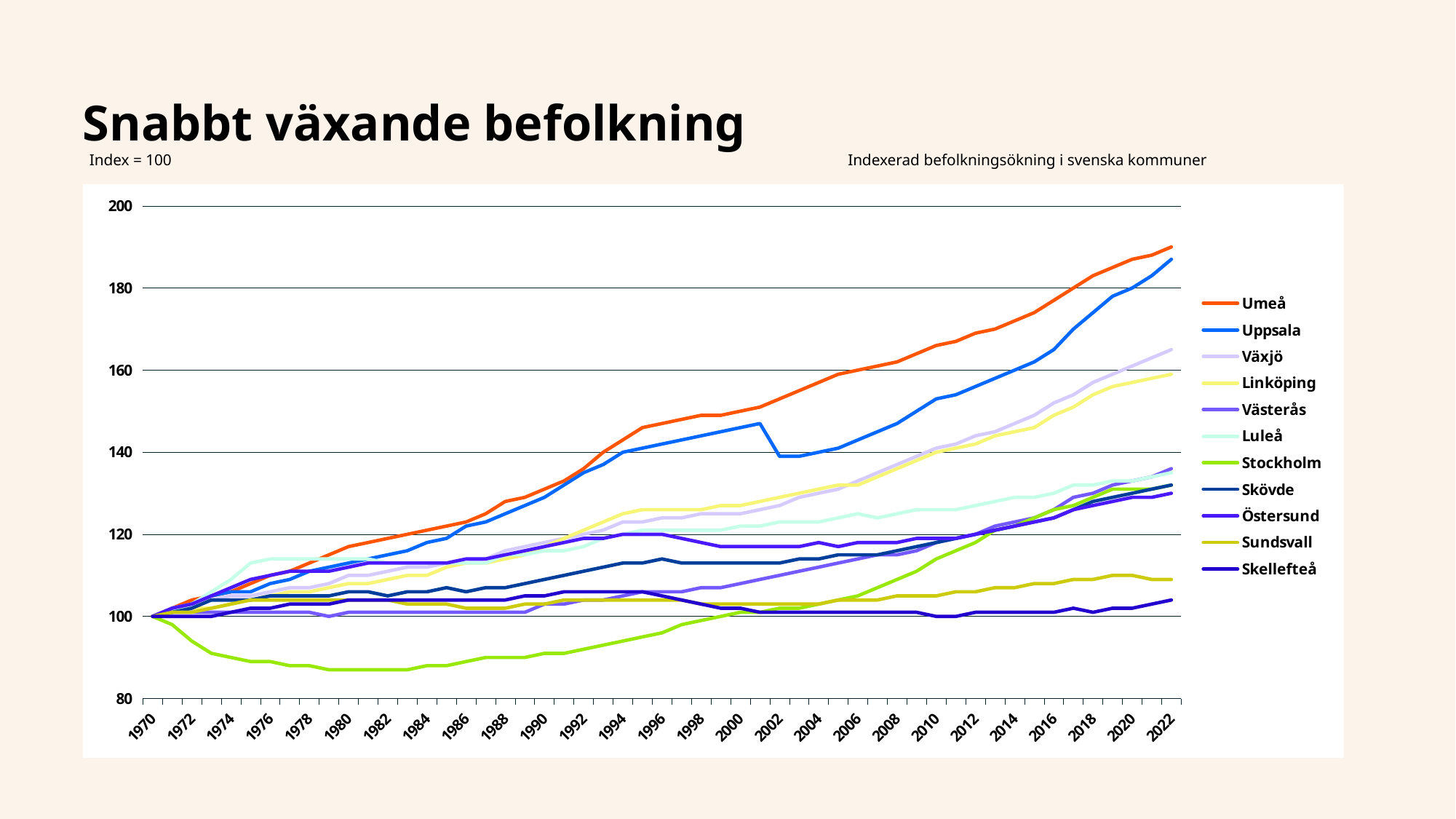
Which municipality has the lowest index value around 1980? Stockholm Which municipality has the highest index value in 2022? Umeå Does the Umeå line rise or fall from 1970 to 2022? rise What is the index value for all municipalities in 1970? 100 In 2022, which is higher, Stockholm or Skellefteå? Stockholm Which municipality has the lowest index value in 2022? Skellefteå How many series does the legend list? 11 Is the value for Stockholm in 1980 greater or less than 100? less Is the value for Sundsvall in 2022 greater or less than 120? less What kind of chart is shown on the slide? line chart Is the value for Uppsala in 2022 greater or less than 180? greater